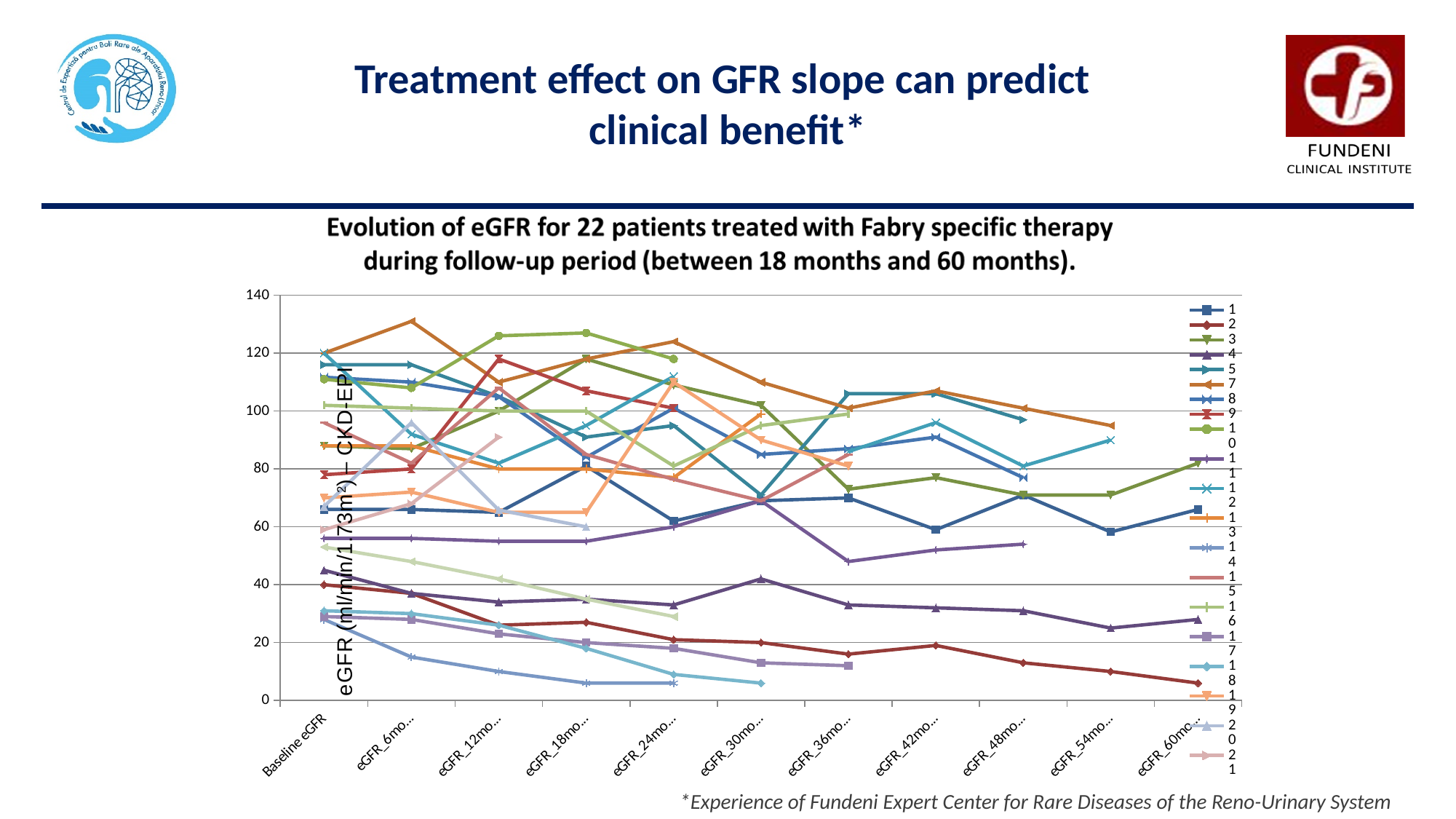
Is the value for series 2 at Baseline eGFR greater or less than series 4 at Baseline eGFR? less Is the value for series 1 at eGFR_60mo greater or less than 40? greater Is the value for series 4 at eGFR_60mo greater or less than 40? less Is the value for series 2 at eGFR_60mo greater or less than 20? less How many time points are shown along the x axis of the chart? 11 What is the label of the y axis of the chart? eGFR (ml/min/1.73m²) – CKD-EPI Does the value for series 2 rise or fall overall from Baseline eGFR to eGFR_60mo? fall What is the title of the chart? Evolution of eGFR for 22 patients treated with Fabry specific therapy during follow-up period (between 18 months and 60 months). What kind of chart is shown on the slide? Line chart